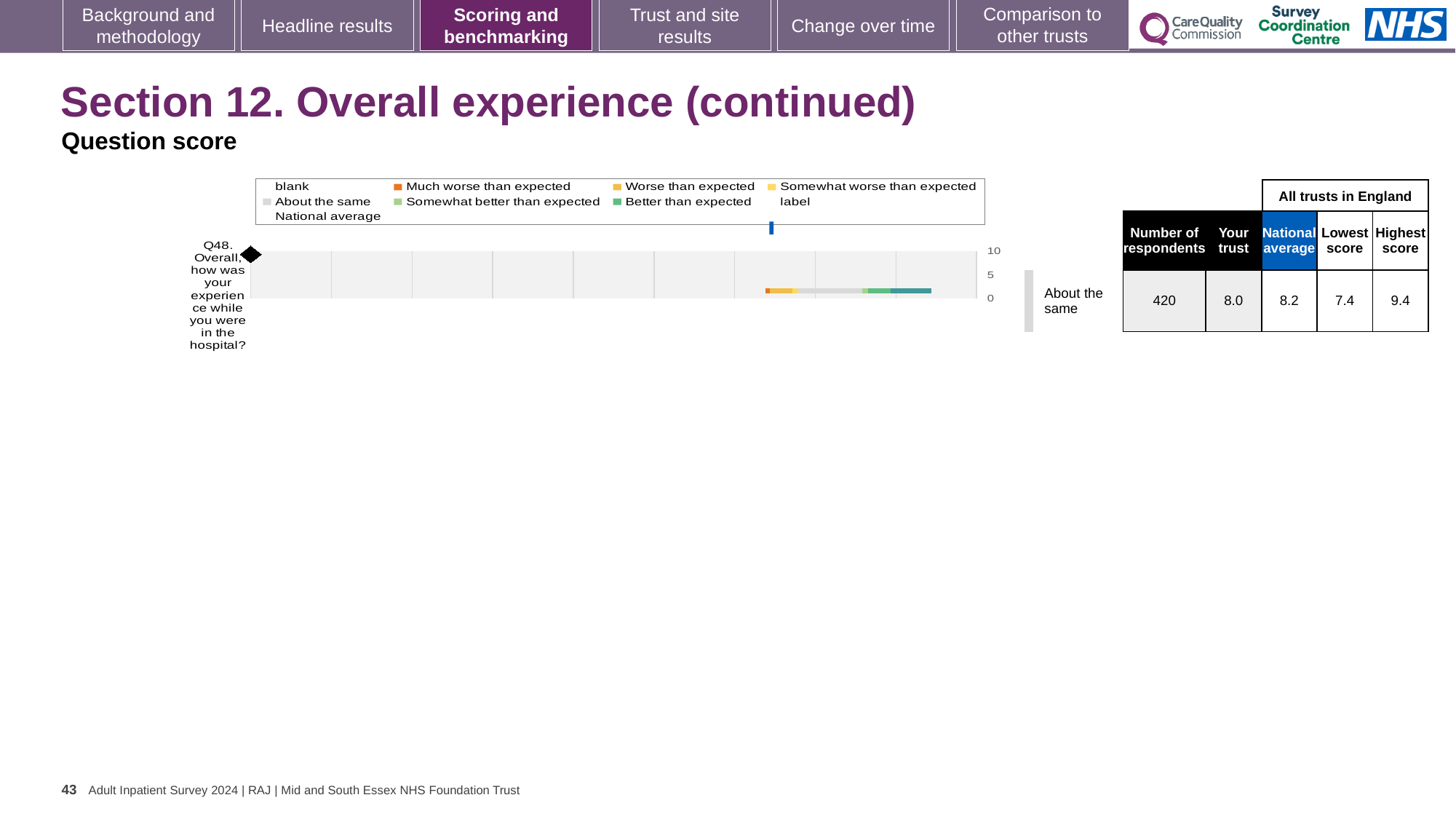
What is the difference between the highest score and the lowest score for Q48? 2.0 Which is larger for Q48: the 'Your trust' score or the national average? National average What is the national average score for Q48? 8.2 What is the lowest score among all trusts in England for Q48? 7.4 By how much does the national average exceed the 'Your trust' score for Q48? 0.2 Which benchmarking category is the trust's Q48 result placed in? About the same How many survey questions are plotted on the chart? 1 How many respondents answered Q48? 420 What is the highest score among all trusts in England for Q48? 9.4 What kind of chart is used to show the Q48 question score? bar chart What is the 'Your trust' score for Q48, 'Overall, how was your experience while you were in the hospital?' 8.0 Is the 'Your trust' score for Q48 greater or less than 5 on the chart's axis? greater